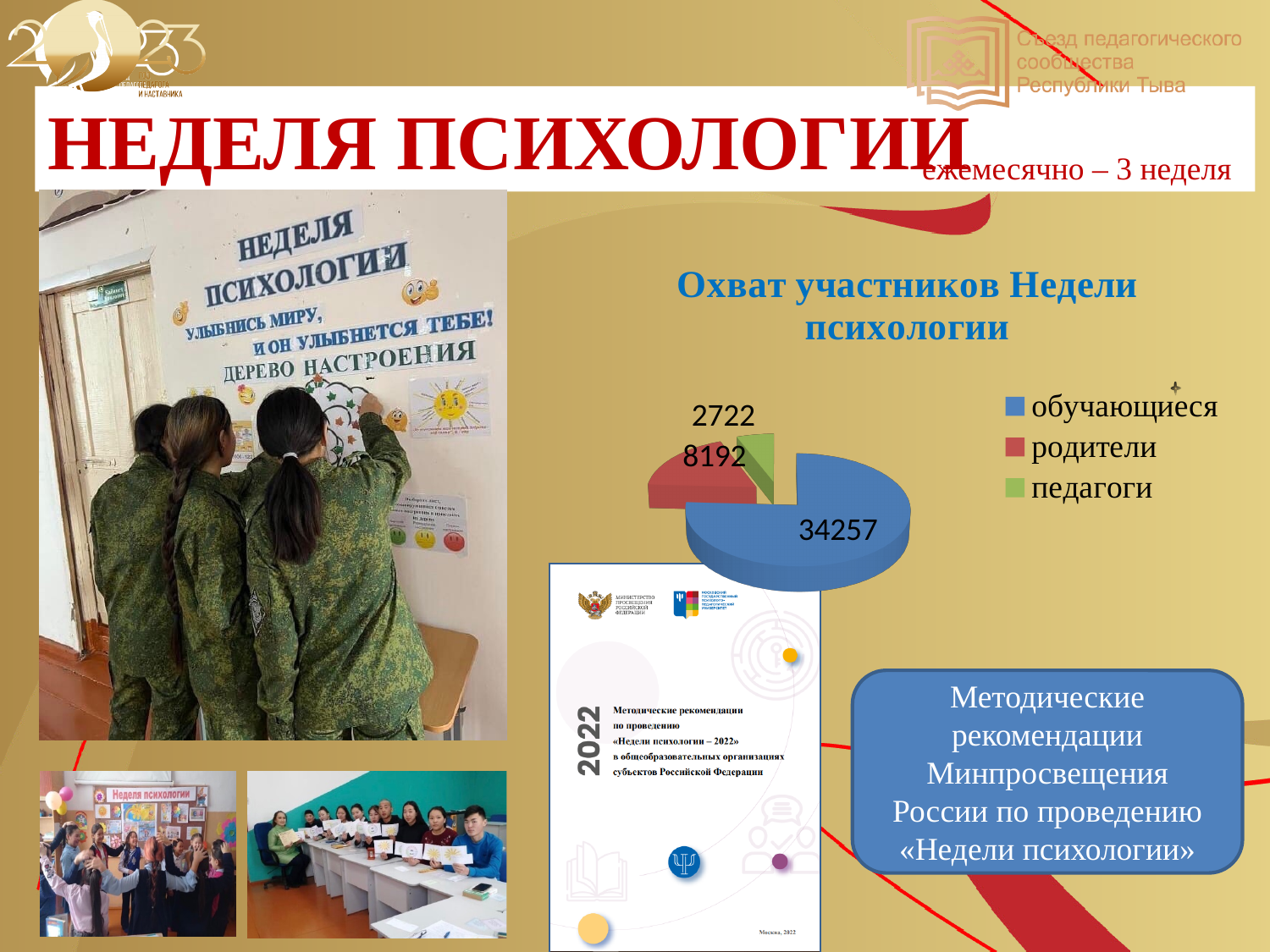
How many entries does the legend of the chart list? 3 What is the difference between the values for обучающиеся and родители? 26065 What is the value for педагоги in the pie chart? 2722 What is the title of the chart? Охват участников Недели психологии Which category has the smallest slice in the pie chart? педагоги What kind of chart is shown on the slide? pie chart Which is larger, the value for родители or the value for педагоги? родители What is the value for родители in the pie chart? 8192 What is the difference between the values for родители and педагоги? 5470 What is the value for обучающиеся in the pie chart? 34257 How many slices does the pie chart have? 3 Which category has the largest slice in the pie chart? обучающиеся